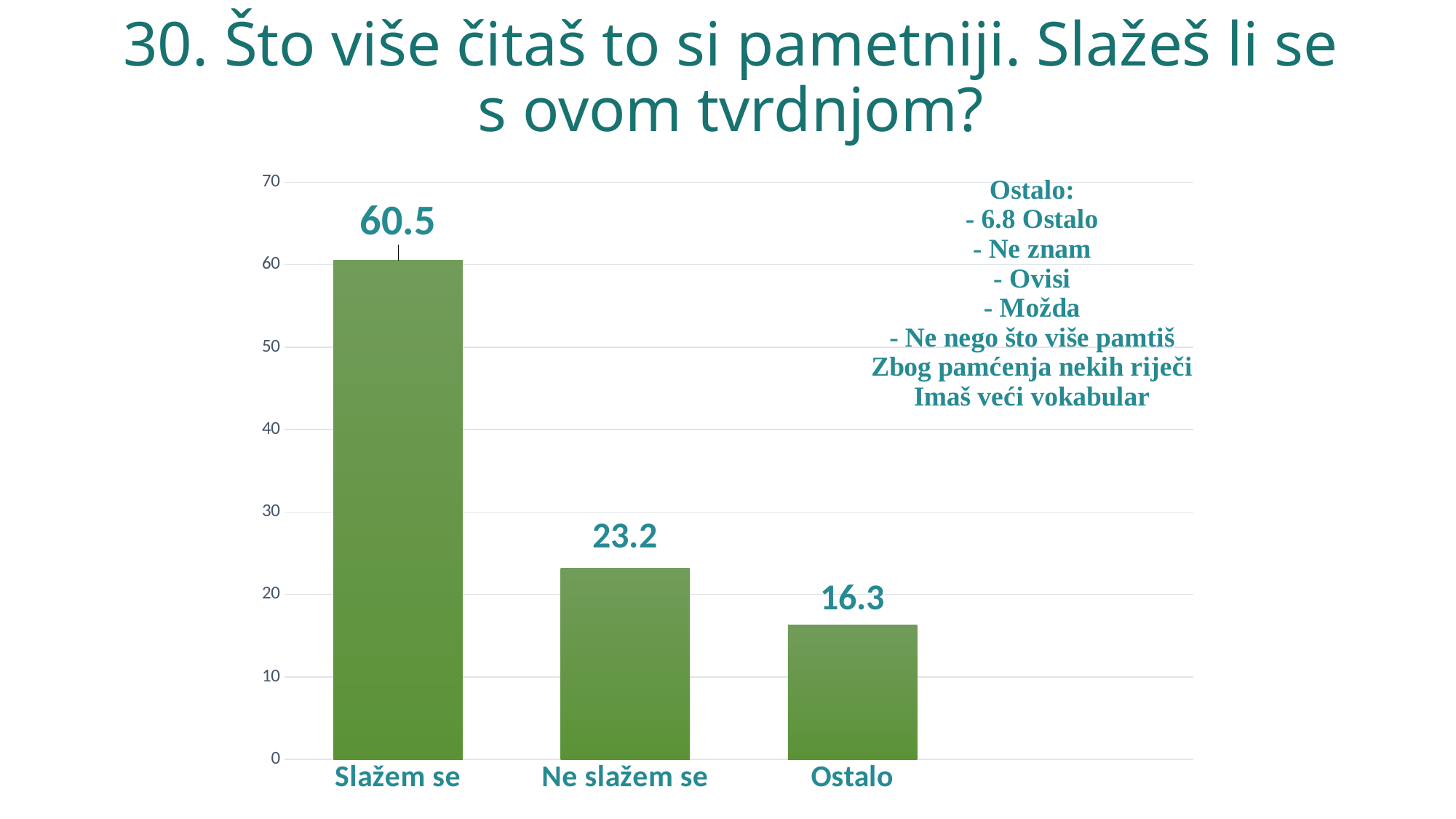
How many categories are shown on the x axis? 3 Is the value for "Slažem se" greater or less than 50? greater What is the difference between the values for "Ne slažem se" and "Ostalo"? 6.9 What is the difference between the values for "Slažem se" and "Ne slažem se"? 37.3 Which is larger, the value for "Ne slažem se" or the value for "Ostalo"? Ne slažem se What is the value for "Ne slažem se"? 23.2 What is the value for "Slažem se"? 60.5 Which category has the lowest value? Ostalo Do the values rise or fall from left to right along the x axis? fall Which category has the highest value? Slažem se What is the value for "Ostalo"? 16.3 What kind of chart is shown on the slide? bar chart